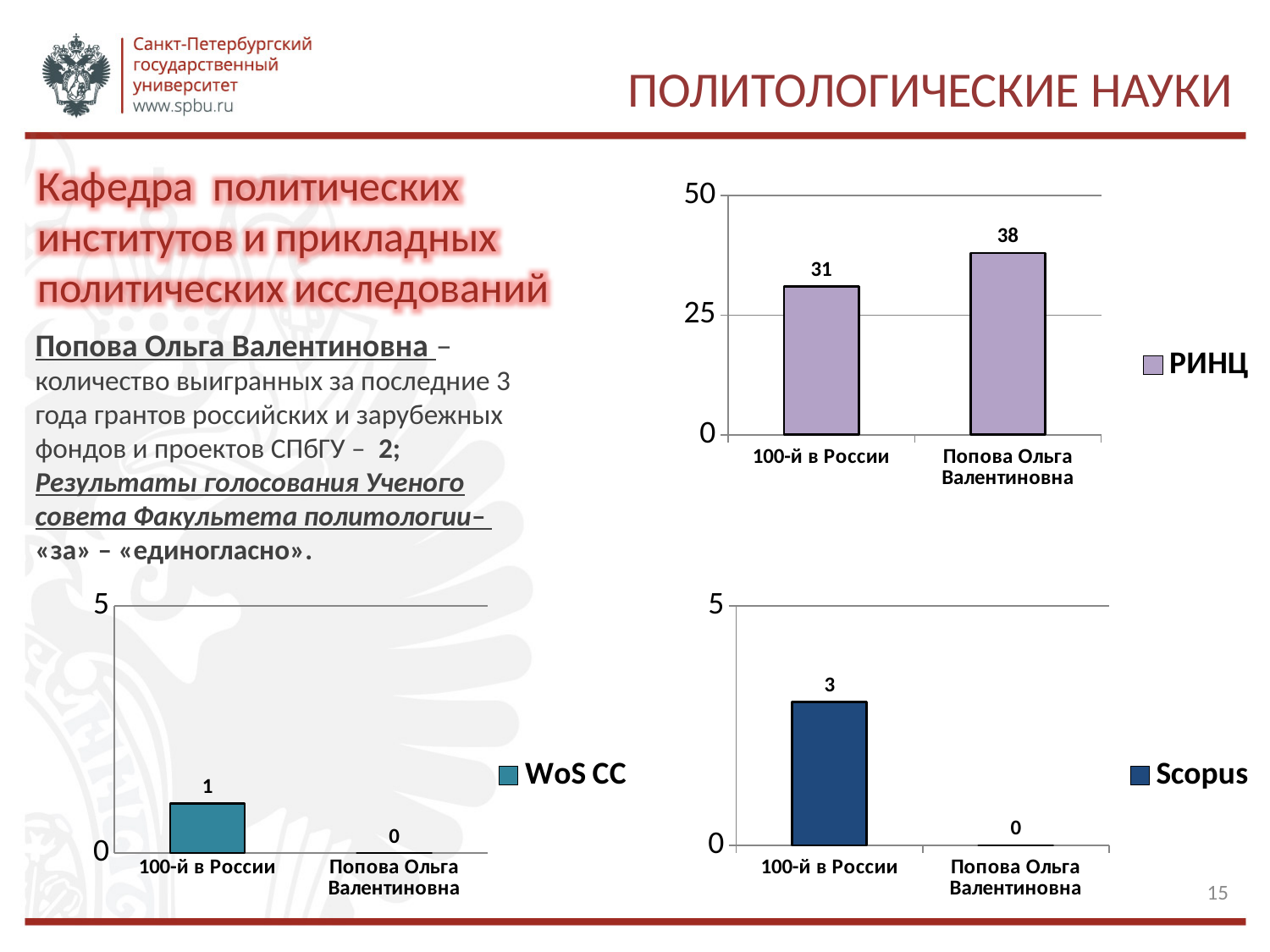
What type of chart is the WoS CC chart? Bar chart In the Scopus chart, what is the value for 100-й в России? 3 In the РИНЦ chart, what is the difference between the values for Попова Ольга Валентиновна and 100-й в России? 7 In the Scopus chart, which category has the lowest value? Попова Ольга Валентиновна In the WoS CC chart, what is the value for 100-й в России? 1 In the WoS CC chart, what is the value for Попова Ольга Валентиновна? 0 In the РИНЦ chart, which category has the higher value? Попова Ольга Валентиновна In the РИНЦ chart, what is the value for Попова Ольга Валентиновна? 38 How many categories are shown in the Scopus chart? 2 In the Scopus chart, what is the difference between the values for 100-й в России and Попова Ольга Валентиновна? 3 In the РИНЦ chart, what is the value for 100-й в России? 31 In the РИНЦ chart, is the value for Попова Ольга Валентиновна greater or less than 25? greater